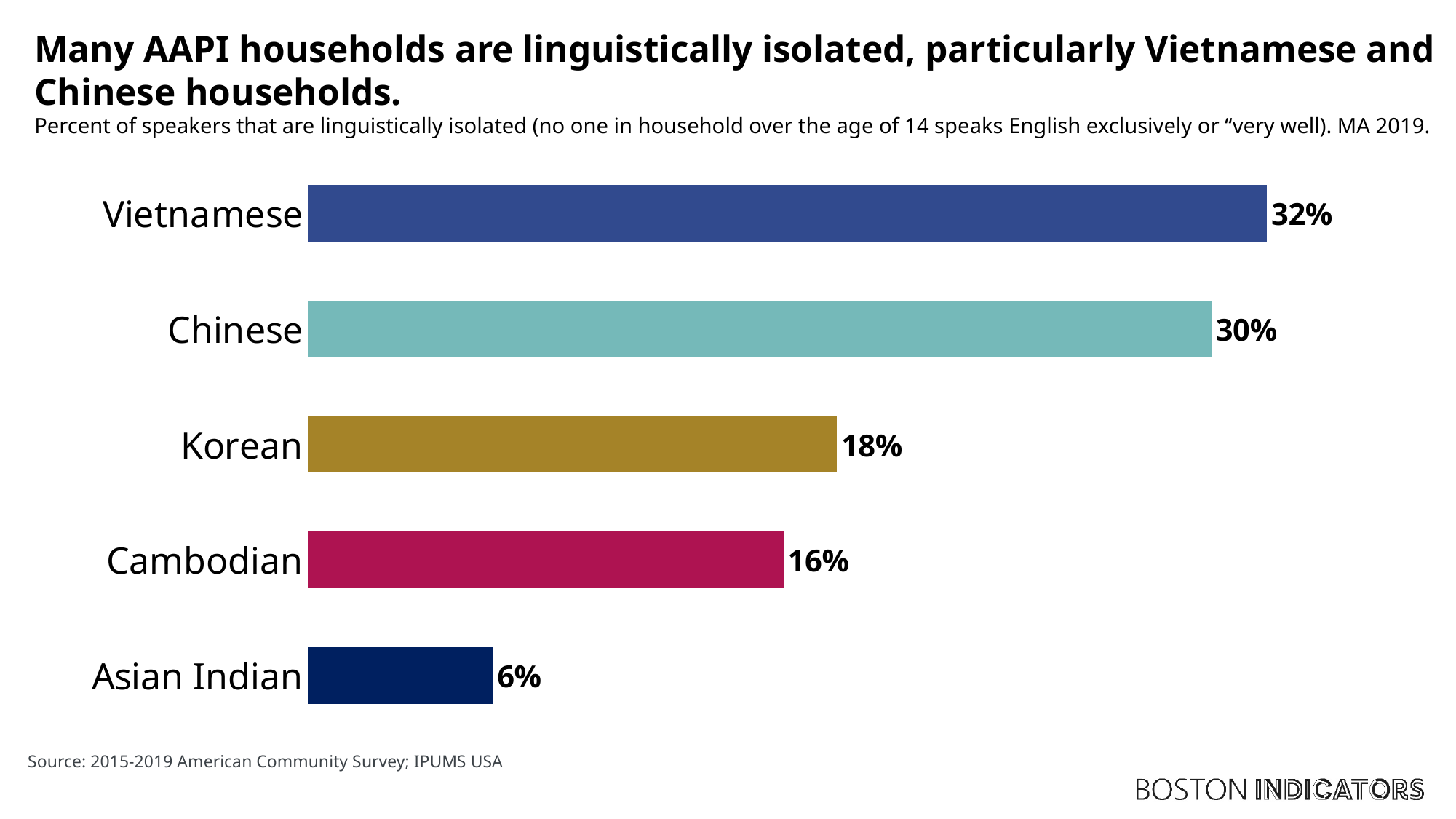
Which group has the highest percent of linguistically isolated speakers? Vietnamese What colour is the bar for Cambodian speakers? Magenta (dark pink) Which is larger, the value for Korean or the value for Cambodian? Korean What percent of Vietnamese speakers are linguistically isolated? 32% What kind of chart is shown on the slide? Bar chart How many groups are shown in the chart? 5 What is the difference in percentage points between the Vietnamese and Chinese values? 2 percentage points Which group has the lowest percent of linguistically isolated speakers? Asian Indian What is the value shown for Asian Indian speakers? 6% What is the difference in percentage points between the Korean and Asian Indian values? 12 percentage points What is the source cited for the chart data? 2015-2019 American Community Survey; IPUMS USA What is the value shown for Korean speakers? 18%